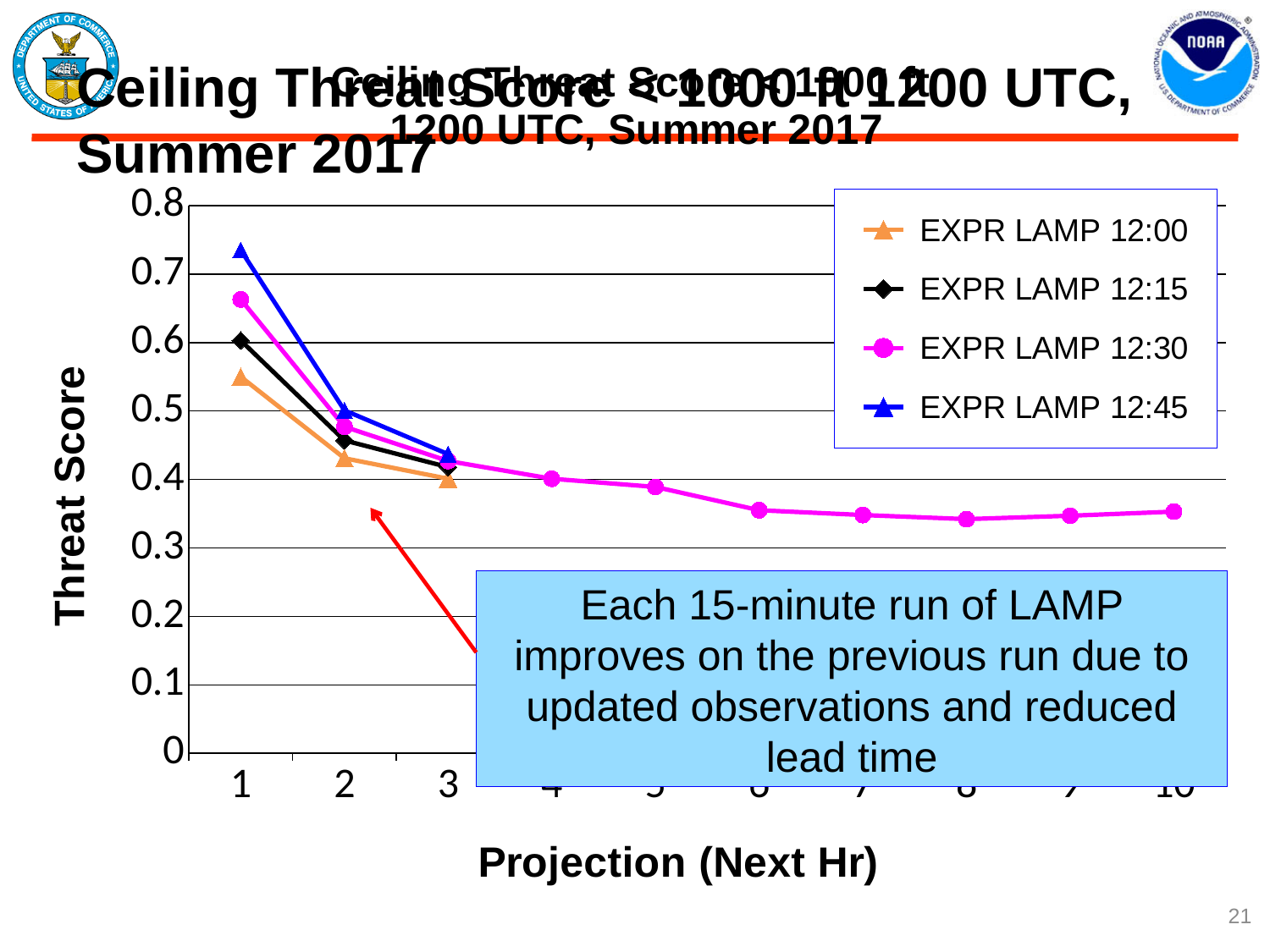
Which series has the lowest threat score at projection 1? EXPR LAMP 12:00 Which series has the highest threat score at projection 1? EXPR LAMP 12:45 Is the threat score for EXPR LAMP 12:30 at projection 1 greater or less than 0.6? greater How many projection points are plotted for the EXPR LAMP 12:30 series? 10 What kind of chart is shown on the slide? line chart Does the threat score for EXPR LAMP 12:30 generally rise or fall as the projection increases? fall At projection 1, which series has the larger threat score, EXPR LAMP 12:45 or EXPR LAMP 12:00? EXPR LAMP 12:45 What is the title of the vertical axis? Threat Score How many series does the legend list? 4 Is the threat score for EXPR LAMP 12:45 at projection 1 greater or less than 0.7? greater Is the threat score for EXPR LAMP 12:00 at projection 2 greater or less than 0.5? less